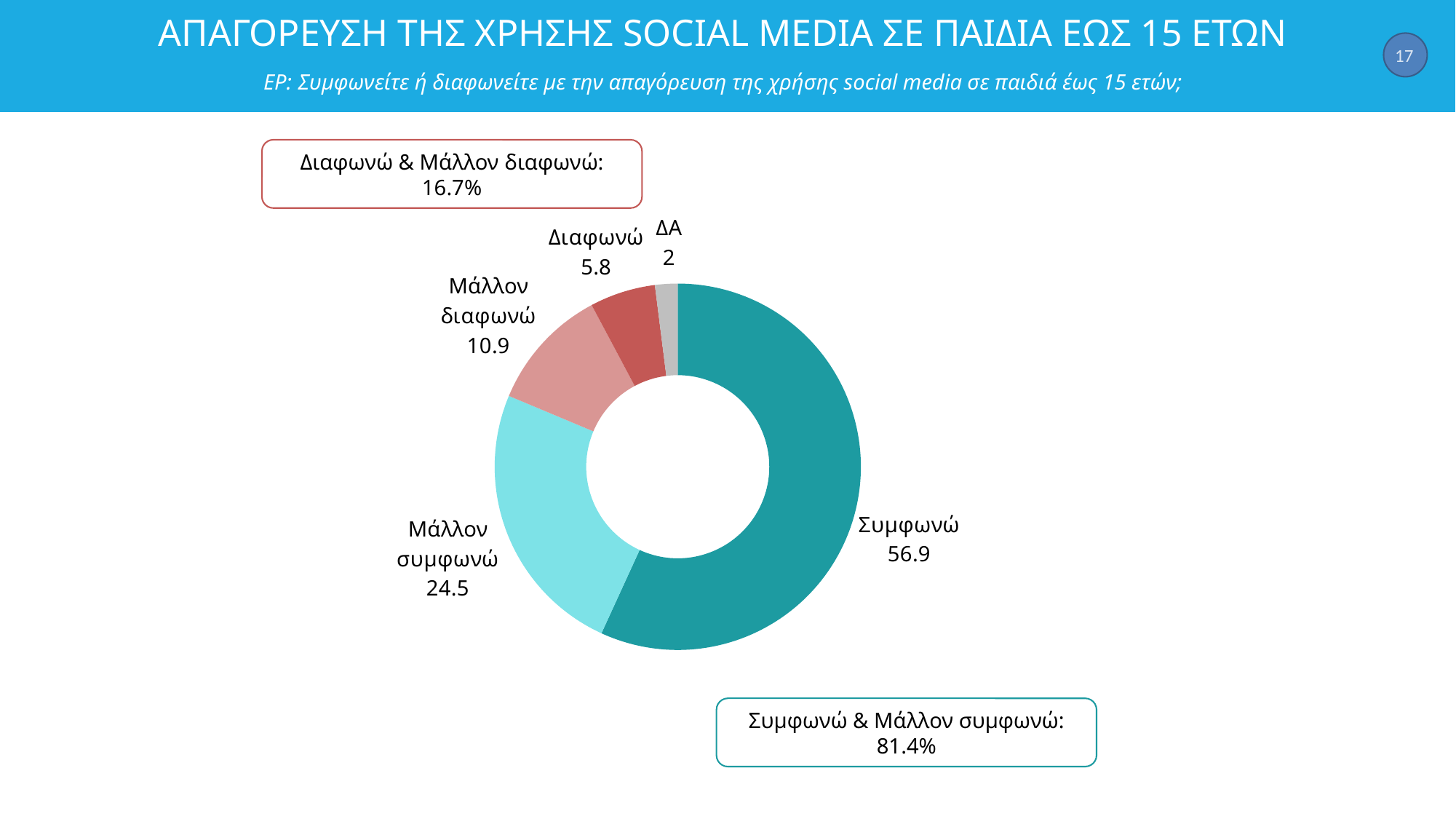
What value is shown for ΔΑ? 2 Which category has the largest slice? Συμφωνώ What value is shown for Μάλλον συμφωνώ? 24.5 What combined percentage is shown in the box for Συμφωνώ & Μάλλον συμφωνώ? 81.4% What kind of chart is shown on the slide? Doughnut (pie) chart Which category has the smallest slice? ΔΑ What is the difference between the values for Συμφωνώ and Μάλλον συμφωνώ? 32.4 What value is shown for Μάλλον διαφωνώ? 10.9 Which is larger, Μάλλον διαφωνώ or Διαφωνώ? Μάλλον διαφωνώ How many categories are shown in the chart? 5 What value is shown for Διαφωνώ? 5.8 What value is shown for Συμφωνώ? 56.9